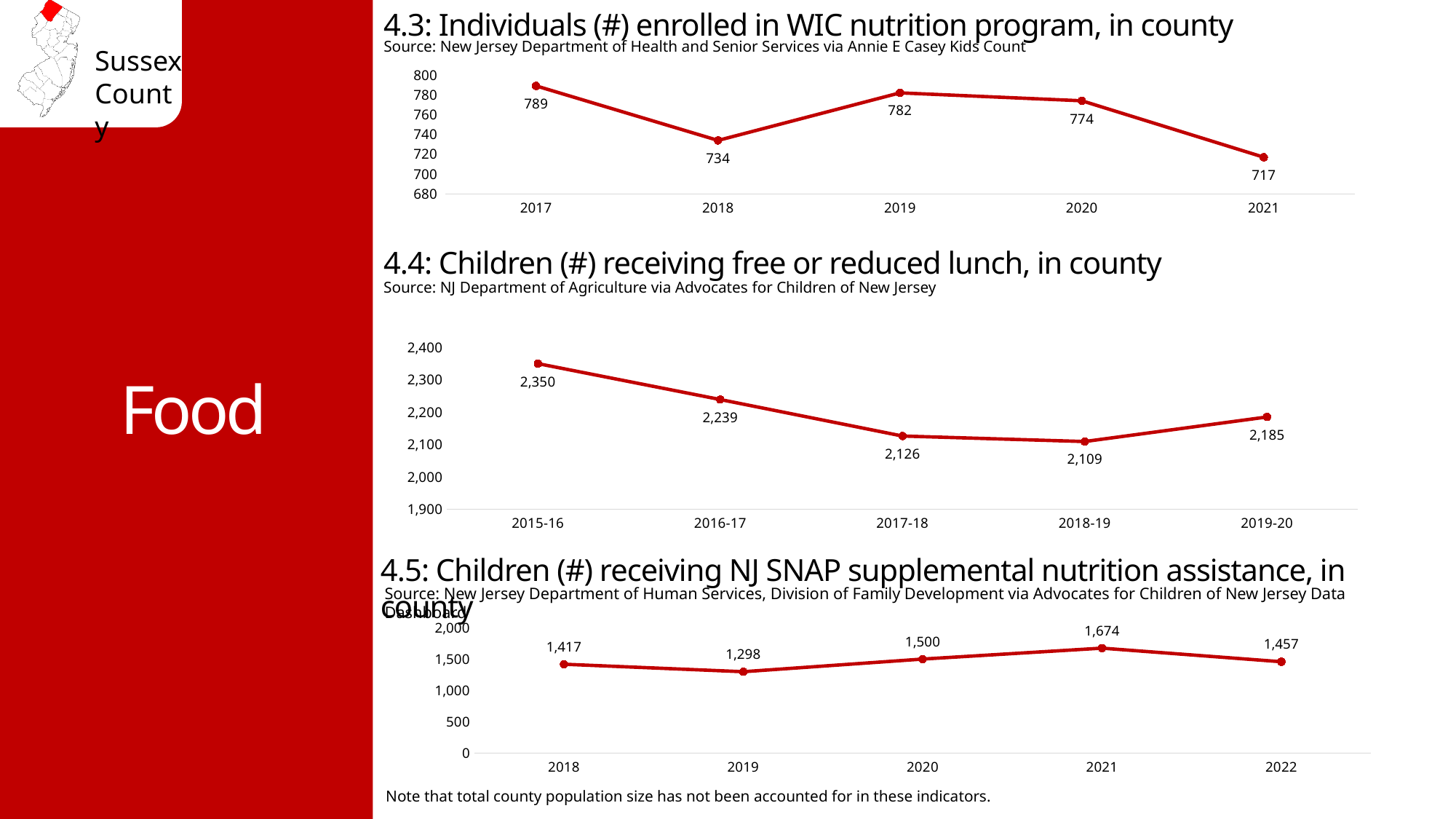
In the chart '4.4: Children (#) receiving free or reduced lunch, in county', which school year has the lowest value? 2018-19 In the chart '4.5: Children (#) receiving NJ SNAP supplemental nutrition assistance, in county', what is the value for 2021? 1,674 In the chart '4.3: Individuals (#) enrolled in WIC nutrition program, in county', how many years are plotted? 5 In the chart '4.5: Children (#) receiving NJ SNAP supplemental nutrition assistance, in county', which year has the lowest value? 2019 In the chart '4.4: Children (#) receiving free or reduced lunch, in county', what is the difference between the 2015-16 and 2016-17 values? 111 In the chart '4.4: Children (#) receiving free or reduced lunch, in county', what is the value for 2017-18? 2,126 What kind of chart is '4.5: Children (#) receiving NJ SNAP supplemental nutrition assistance, in county'? line chart In the chart '4.4: Children (#) receiving free or reduced lunch, in county', is the value for 2016-17 larger or smaller than the value for 2019-20? larger In the chart '4.3: Individuals (#) enrolled in WIC nutrition program, in county', what is the value for 2018? 734 In the chart '4.4: Children (#) receiving free or reduced lunch, in county', do the values rise or fall from 2015-16 to 2018-19? fall In the chart '4.3: Individuals (#) enrolled in WIC nutrition program, in county', which year has the highest value? 2017 In the chart '4.3: Individuals (#) enrolled in WIC nutrition program, in county', what is the difference between the 2017 and 2021 values? 72